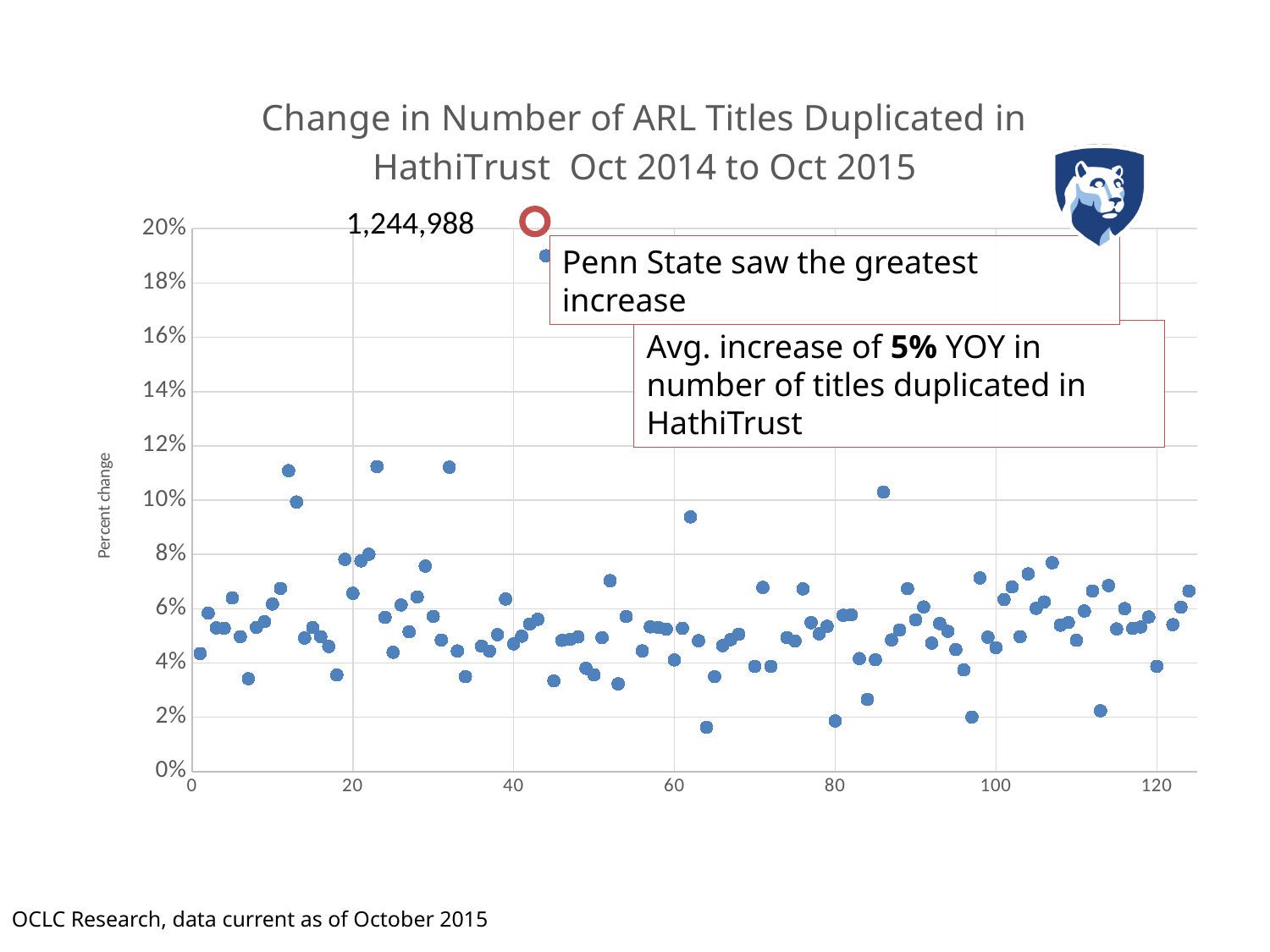
Is the value of the highest point on the chart greater or less than 18%? greater Is the value of the point near x = 12 greater or less than 10%? greater Is the value of the lowest point on the chart greater or less than 2%? less What is the label on the y axis of the chart? Percent change What is the title of the chart? Change in Number of ARL Titles Duplicated in HathiTrust Oct 2014 to Oct 2015 What is the average year-over-year increase in number of titles duplicated in HathiTrust stated on the slide? 5% According to the slide, which institution saw the greatest increase in titles duplicated in HathiTrust? Penn State What is the highest value shown on the y axis of the chart? 20% What number is printed next to the highest point on the chart? 1,244,988 What kind of chart is shown on the slide? scatter chart